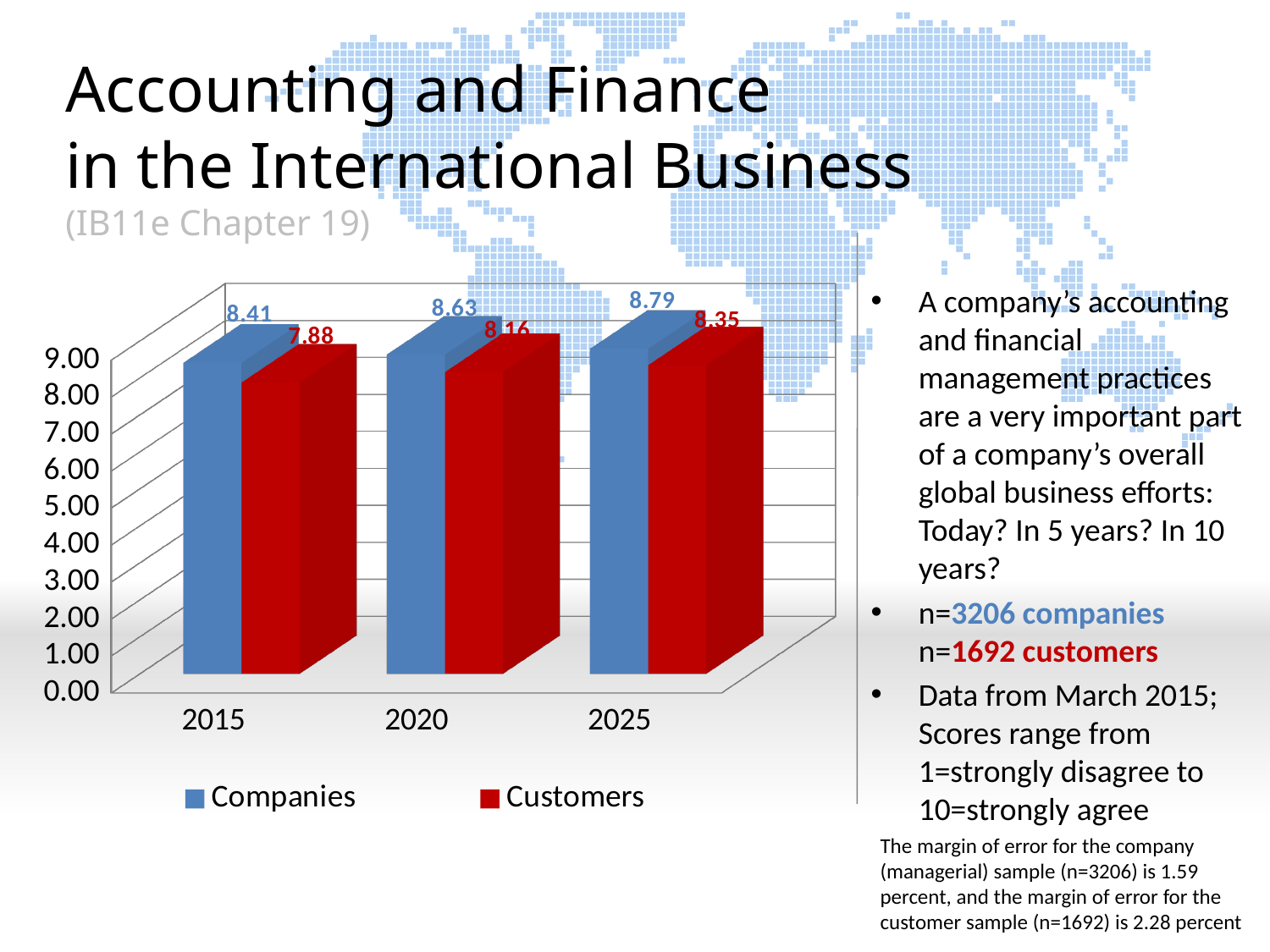
Which year has the highest value for Customers? 2025 How many years are shown on the x axis? 3 Do the Companies values rise or fall from 2015 to 2025? rise How many series does the legend list? 2 What is the value for Companies in 2025? 8.79 What is the value for Companies in 2015? 8.41 Which year has the lowest value for Companies? 2015 What kind of chart is shown on the slide? bar chart What is the value for Customers in 2015? 7.88 What is the value for Customers in 2020? 8.16 Which is larger in 2025, the Companies value or the Customers value? Companies What is the difference between the Companies and Customers values in 2015? 0.53